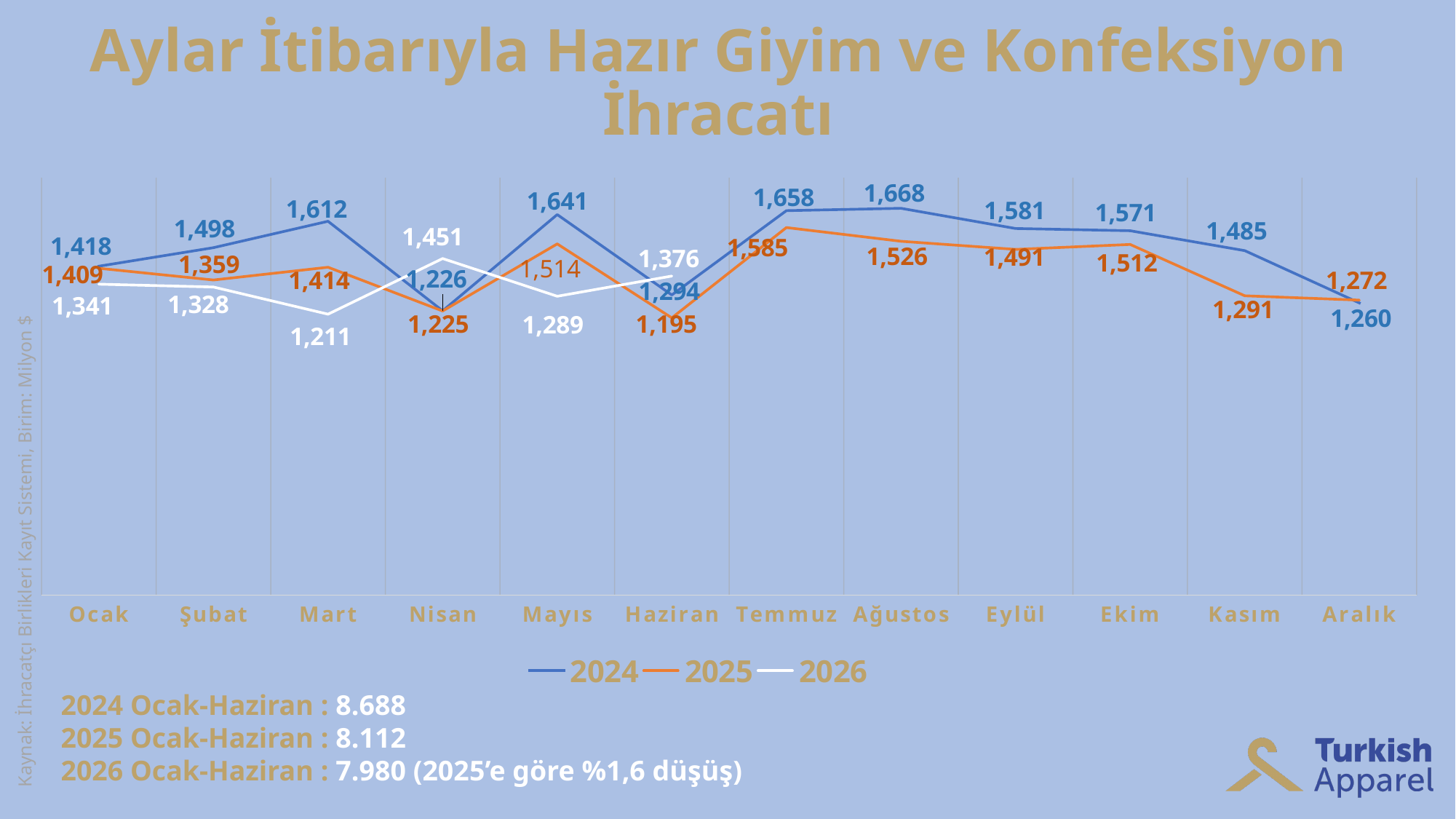
In which month is the 2024 series highest? Ağustos Which colour is used for the 2025 series? Orange What is the 2026 value for Nisan? 1,451 What is the 2024 value for Ağustos? 1,668 In which month is the 2026 series lowest? Mart What type of chart is shown on the slide? Line chart How many series does the legend list? 3 How many months are shown on the x axis? 12 What is the difference between the 2024 and 2025 values for Mart? 198 Does the 2024 series rise or fall from Ağustos to Aralık? Fall Which is larger for Nisan, the 2026 value or the 2025 value? 2026 What is the 2025 value for Haziran? 1,195